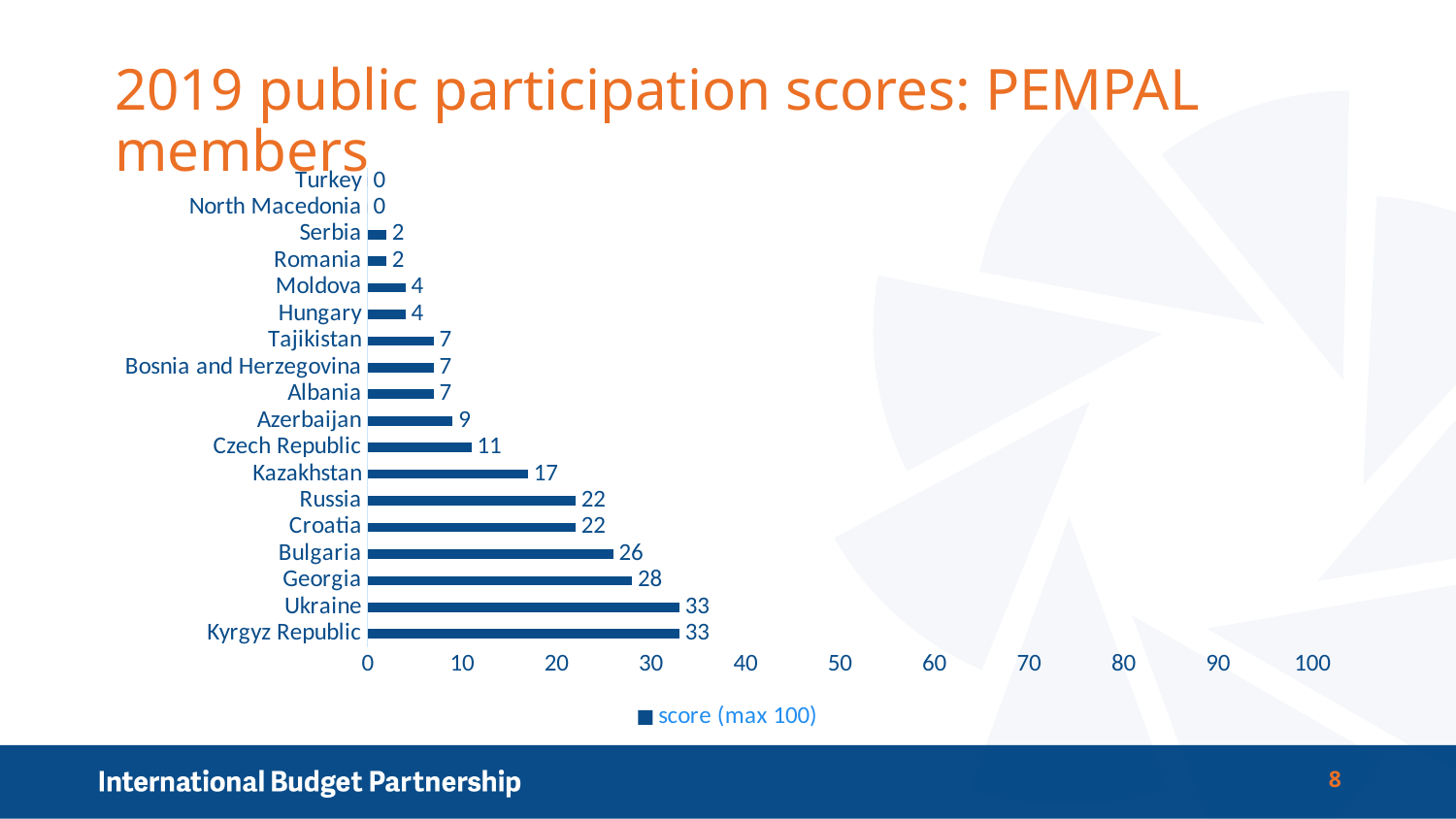
How many series does the legend list? 1 What is the score for Azerbaijan? 9 What is the score for Georgia? 28 Which has a higher score, Georgia or Croatia? Georgia What is the difference between the scores of Russia and Moldova? 18 What is the score for Czech Republic? 11 What is the difference between the scores of Ukraine and Bulgaria? 7 How many countries are shown in the chart? 18 Which has a higher score, Kazakhstan or Tajikistan? Kazakhstan What is the legend entry for the series in the chart? score (max 100) What kind of chart is shown on the slide? Bar chart What is the score for Kazakhstan? 17